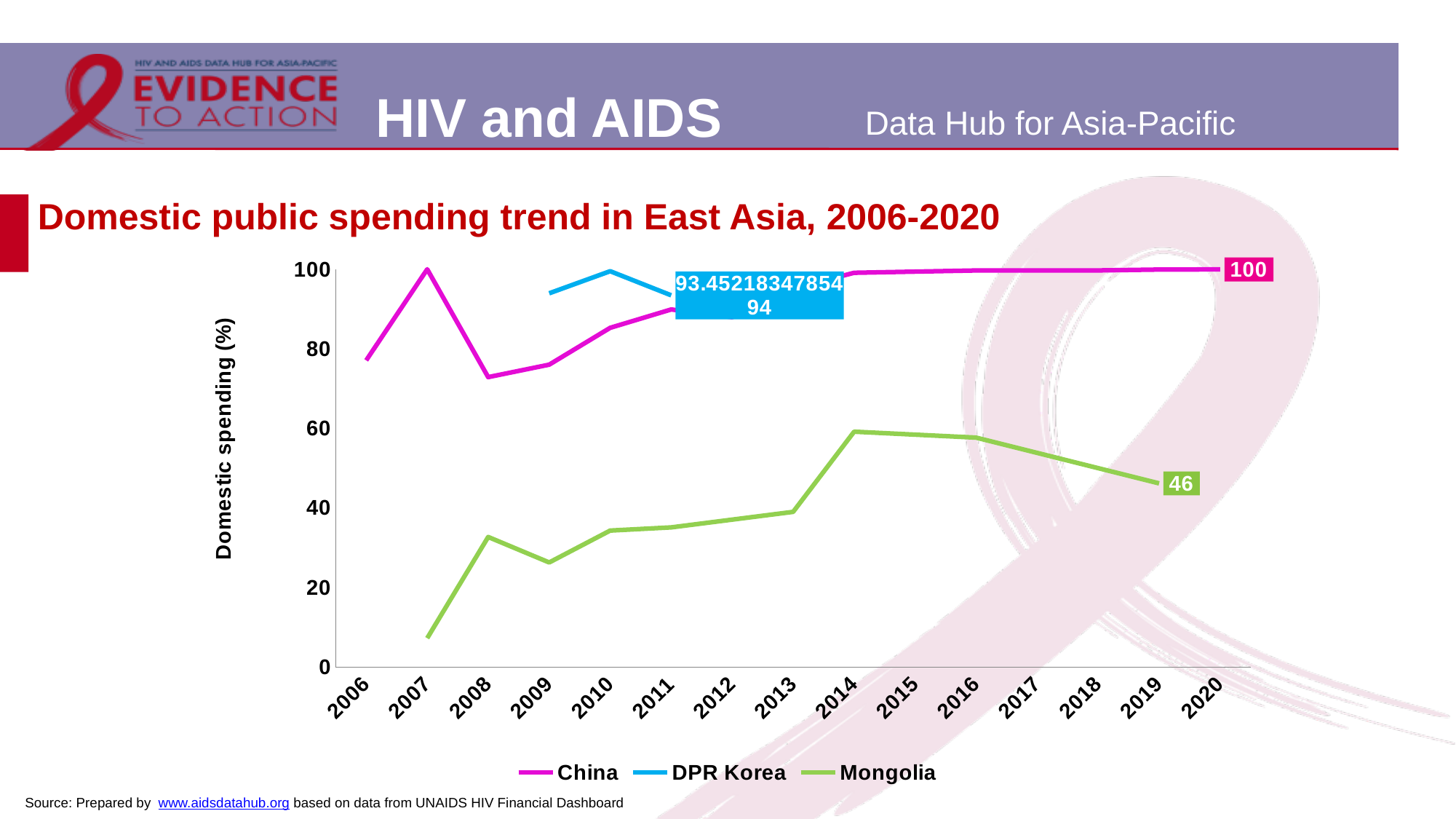
Does the Mongolia line rise or fall between 2014 and 2019? Fall How many series does the legend list? 3 What is the difference between China's labelled 2020 value and Mongolia's labelled 2019 value? 54 Is the value for Mongolia in 2007 greater or less than 20? less Is the value for China in 2008 greater or less than 80? less What is the title of the chart? Domestic public spending trend in East Asia, 2006-2020 What kind of chart is shown on the slide? Line chart How many years are shown on the x axis? 15 What is the labelled value for DPR Korea in 2011? 93.4521834785494 What is the labelled value for Mongolia in 2019? 46 Which series has the higher value in 2019, China or Mongolia? China What is the labelled value for China in 2020? 100